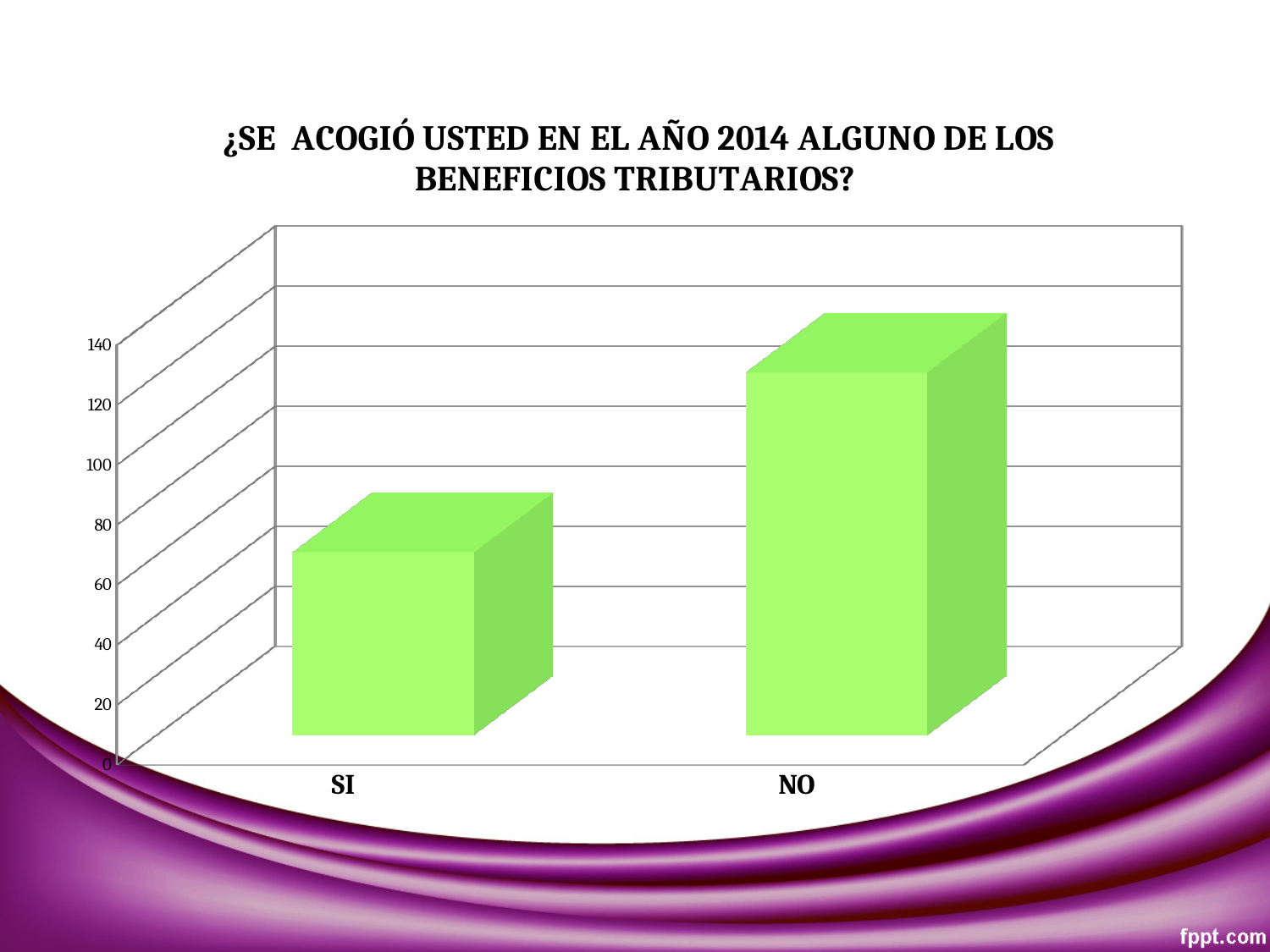
What is the title of the chart? ¿SE ACOGIÓ USTED EN EL AÑO 2014 ALGUNO DE LOS BENEFICIOS TRIBUTARIOS? What colour are the bars in the chart? green Which category has the lowest value in the chart? SI How many categories are shown on the x axis of the chart? 2 Do the values rise or fall moving from SI to NO along the x axis? rise Which is larger, the value for SI or the value for NO? NO Is the value for SI greater or less than 100? less Is the value for SI greater or less than 40? greater What kind of chart is shown on the slide? bar chart Is the value for NO greater or less than 100? greater Which category has the highest value in the chart? NO